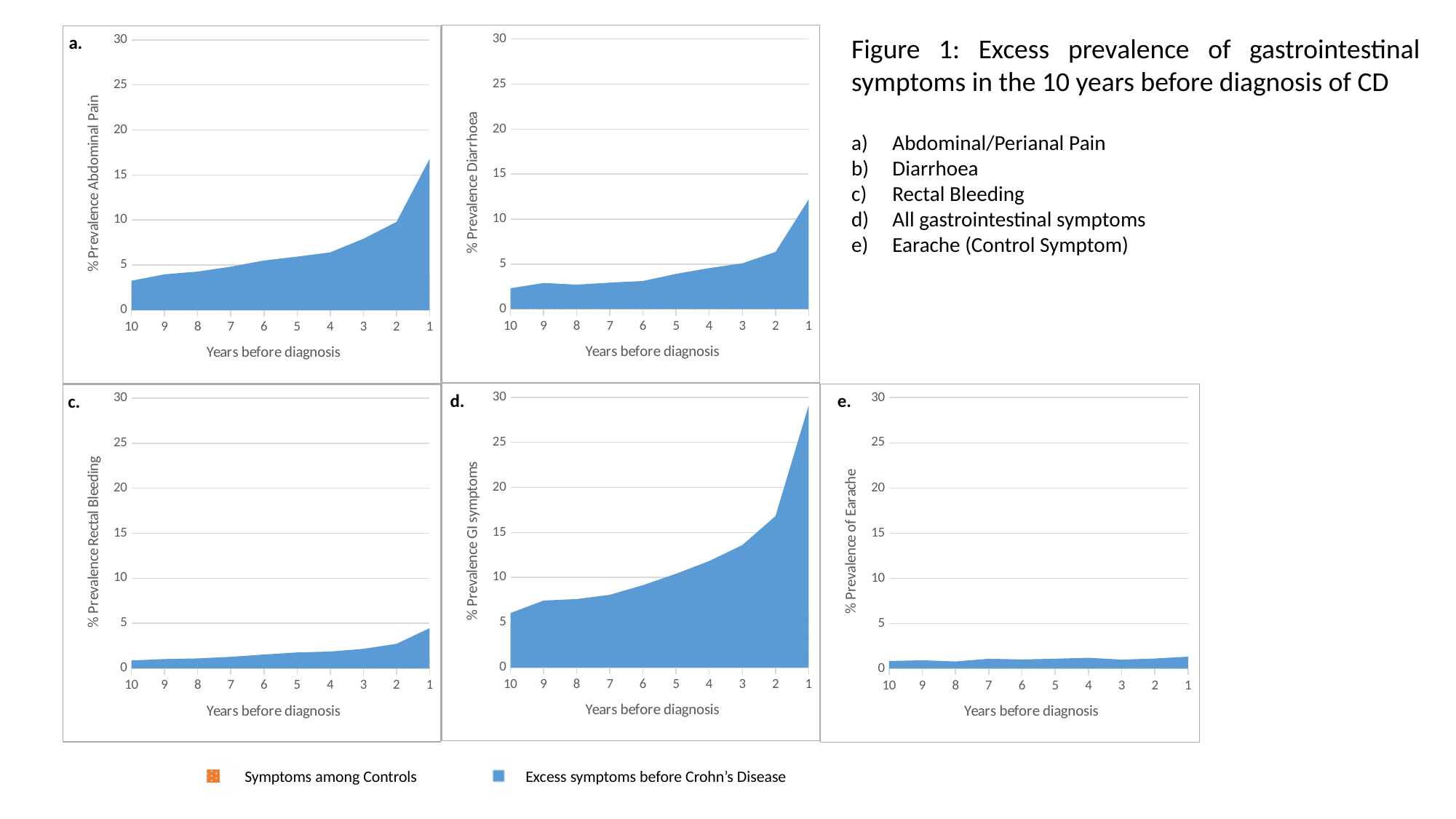
In chart b (% Prevalence Diarrhoea), is the value at 10 years before diagnosis greater or less than 5? less In chart d (% Prevalence GI symptoms), is the value at 10 years before diagnosis greater or less than 5? greater In chart a (% Prevalence Abdominal Pain), is the value at 10 years before diagnosis greater or less than 5? less In chart d (% Prevalence GI symptoms), do the values rise or fall moving from 10 years before diagnosis to 1 year before diagnosis? Rise What kind of chart is chart a (% Prevalence Abdominal Pain)? Area chart How many entries does the legend at the bottom of the slide list? 2 How many points along the x axis (years before diagnosis) does chart d (% Prevalence GI symptoms) show? 10